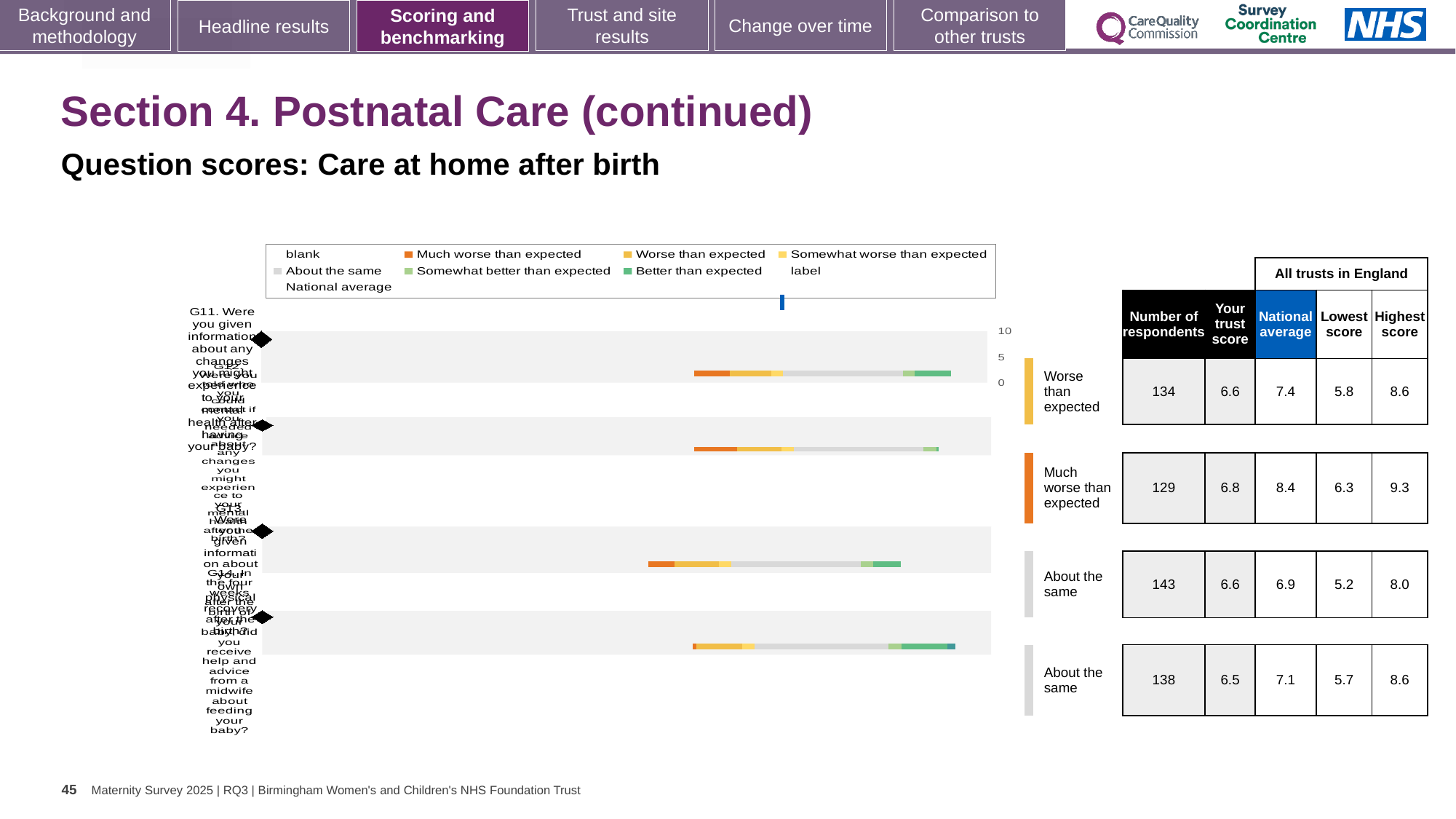
In the table, what is the number of respondents for the first row (G11)? 134 What is the title of the chart section on the slide? Question scores: Care at home after birth In the table, what is the national average for the fourth (bottom) row? 7.1 For the first row (G11), is the trust score larger or smaller than the national average? Smaller What kind of chart is shown on the slide? Bar chart How many question bars are plotted in the chart? 4 For the row labelled "Much worse than expected", what is the difference between the national average and the trust score? 1.6 Which table row has the lowest "Lowest score" value? The third row, 5.2 In the table, what is the trust score for the row labelled "Much worse than expected"? 6.8 In the legend, what colour represents "Much worse than expected"? Orange How many entries does the chart legend list? 9 Which table row has the highest "Highest score" value? The second row (Much worse than expected), 9.3